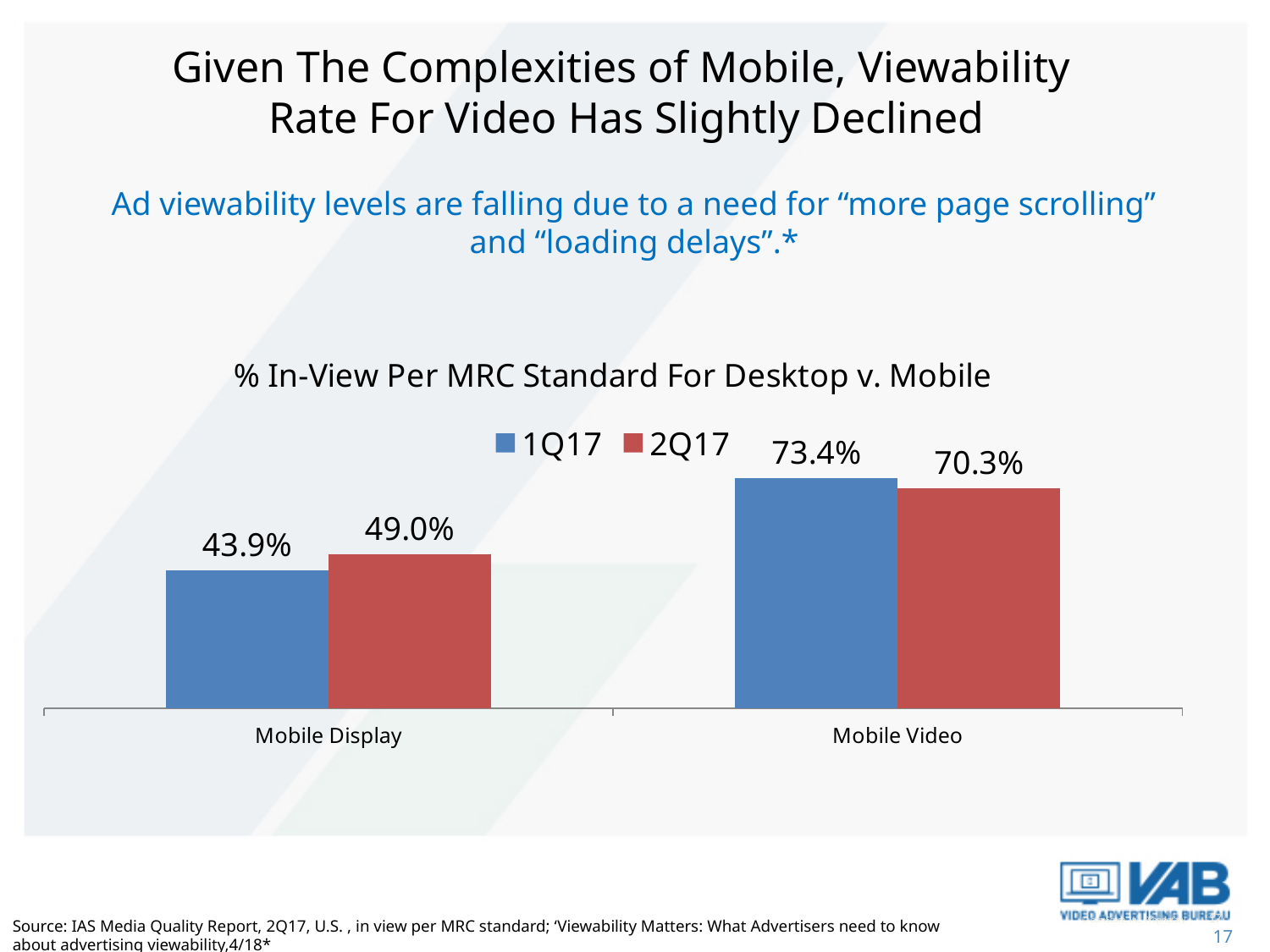
Which category has the lowest 2Q17 value? Mobile Display How many series does the legend list? 2 How many categories are shown on the x axis? 2 What is the difference between the 2Q17 and 1Q17 values for Mobile Display? 5.1% Which category has the highest 1Q17 value? Mobile Video What is the 2Q17 value for Mobile Display? 49.0% What is the difference between the 1Q17 and 2Q17 values for Mobile Video? 3.1% What is the 1Q17 value for Mobile Display? 43.9% What kind of chart is shown on the slide? Bar chart What is the 2Q17 value for Mobile Video? 70.3% What is the title of the chart? % In-View Per MRC Standard For Desktop v. Mobile Which is larger for Mobile Display: the 1Q17 value or the 2Q17 value? 2Q17